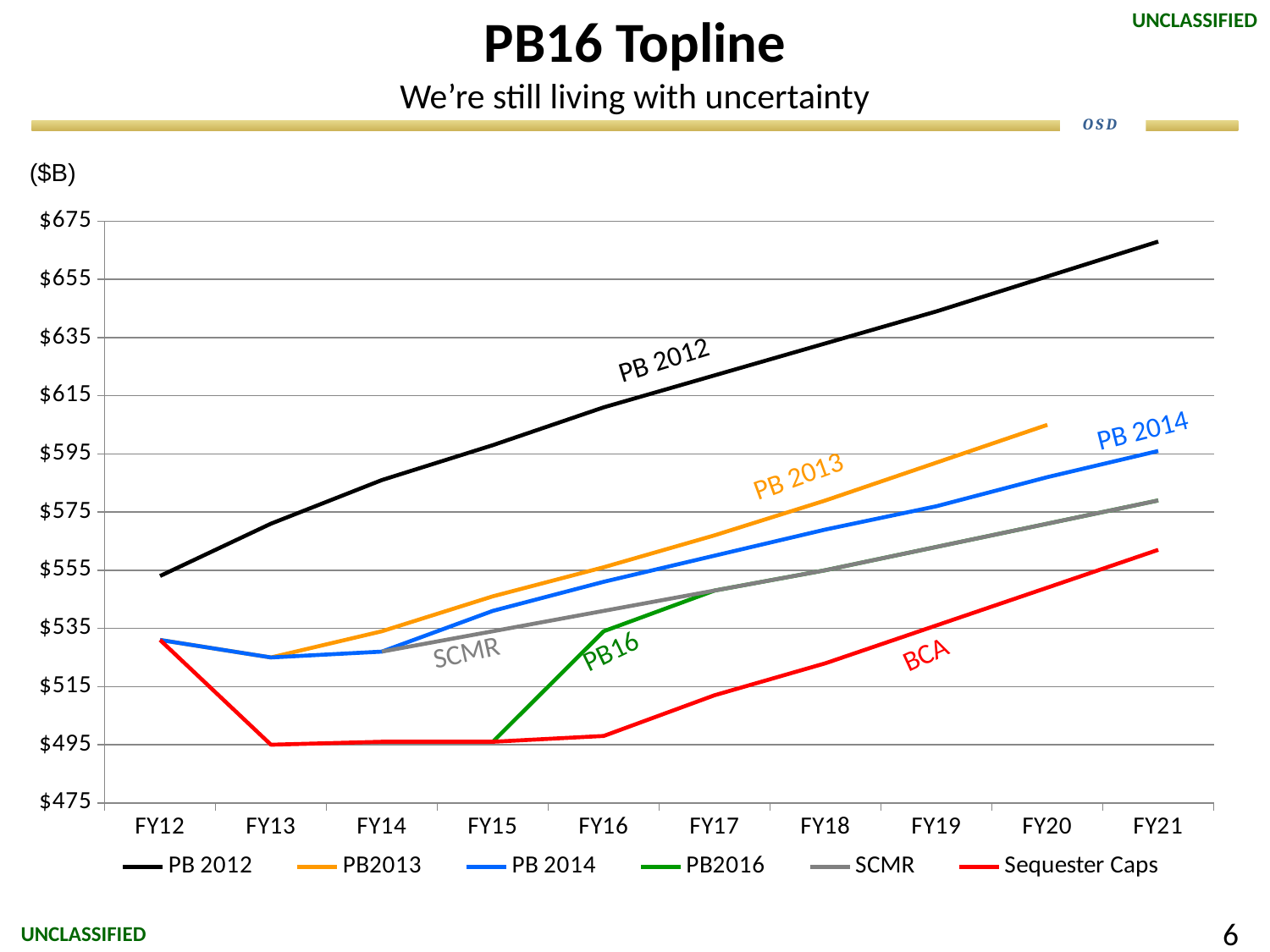
At FY20, which is higher: PB2013 or PB 2014? PB2013 How many fiscal years are shown on the x axis? 10 How many series does the legend list? 6 Which series has the highest value at FY21? PB 2012 Does the Sequester Caps line rise or fall from FY12 to FY13? falls Is the value for SCMR at FY21 greater or less than $595? less Is the value for Sequester Caps at FY13 greater or less than $515? less Which series has the lowest value at FY21? Sequester Caps What kind of chart is shown on the slide? line chart Is the value for PB 2012 at FY21 greater or less than $655? greater Does the PB 2012 line rise or fall from FY12 to FY21? rises